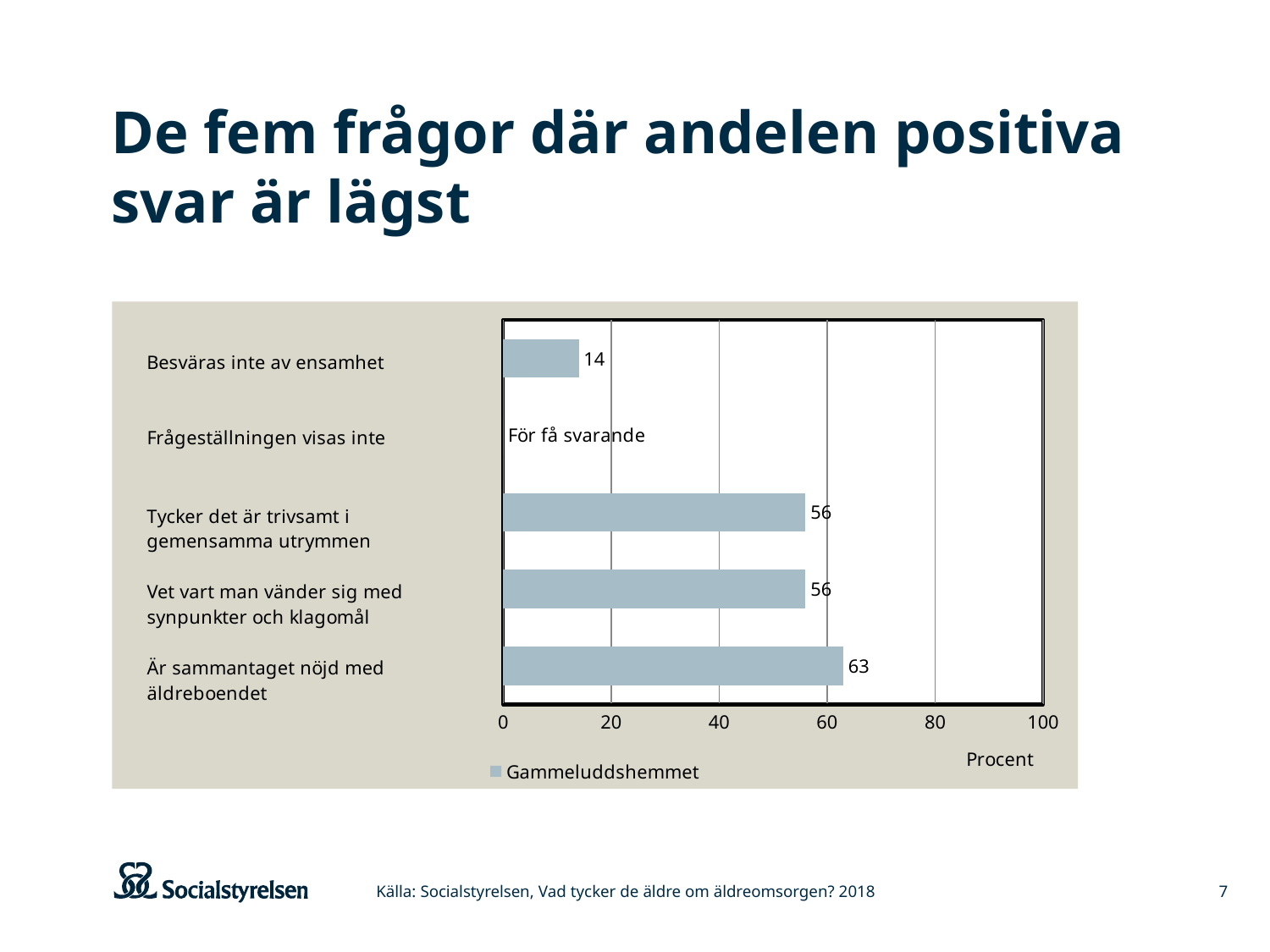
What is the value for "Besväras inte av ensamhet"? 14 Which is larger, the value for "Är sammantaget nöjd med äldreboendet" or for "Vet vart man vänder sig med synpunkter och klagomål"? Är sammantaget nöjd med äldreboendet What is the value for "Tycker det är trivsamt i gemensamma utrymmen"? 56 How many categories are listed on the chart? 5 How many series does the legend list? 1 Is the value for "Besväras inte av ensamhet" greater or less than 20? less Which category has the highest value? Är sammantaget nöjd med äldreboendet What is the value for "Är sammantaget nöjd med äldreboendet"? 63 What text is shown instead of a bar for "Frågeställningen visas inte"? För få svarande What kind of chart is shown? bar chart Which category has the lowest plotted value? Besväras inte av ensamhet What is the difference between the values for "Är sammantaget nöjd med äldreboendet" and "Besväras inte av ensamhet"? 49